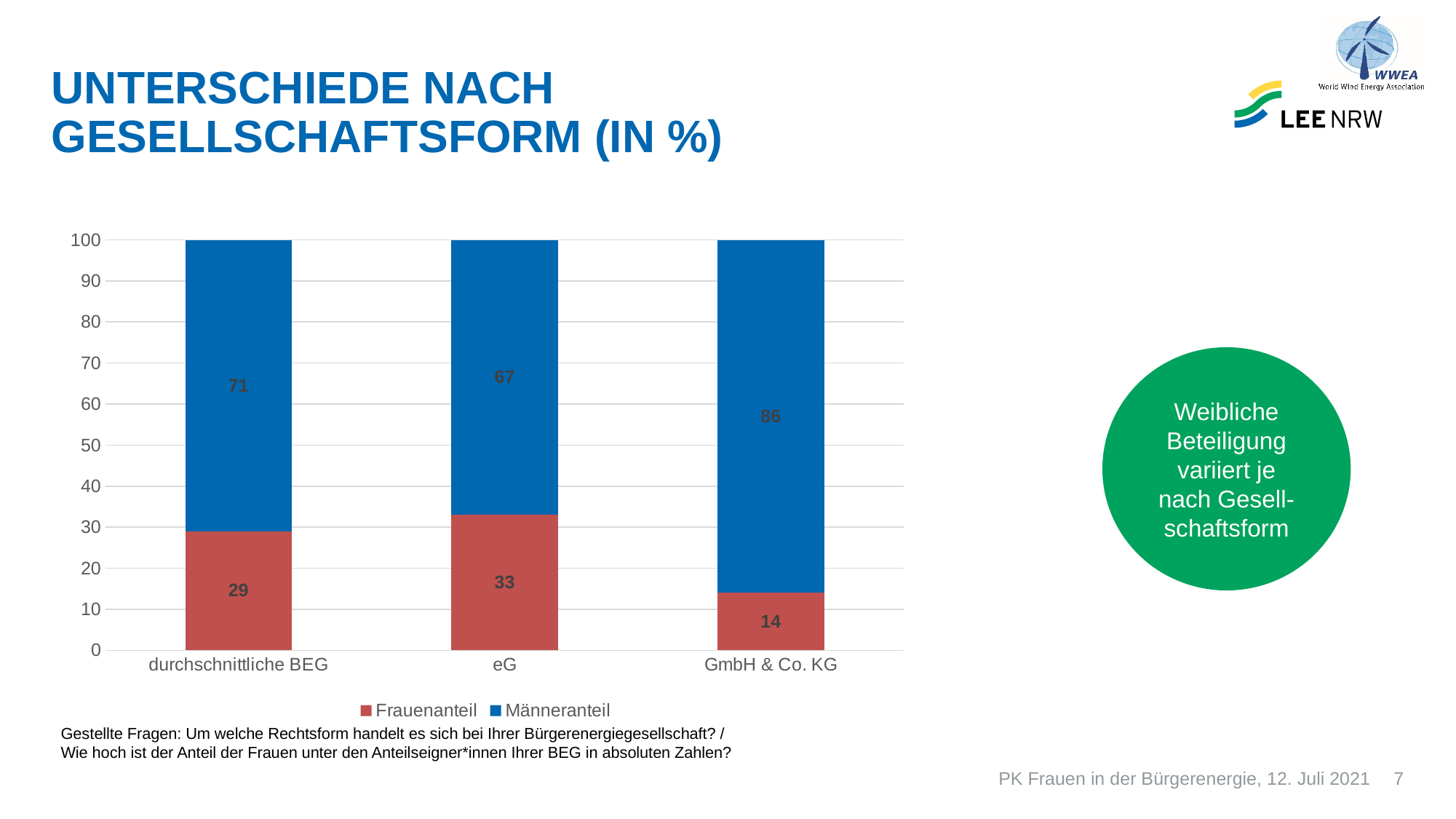
Which colour represents Frauenanteil in the chart? Red Which category has the highest Frauenanteil? eG What is the Frauenanteil value for durchschnittliche BEG? 29 Which category has the lowest Frauenanteil? GmbH & Co. KG How many series does the legend list? 2 What is the total of the stacked bar for eG? 100 What kind of chart is shown on the slide? Stacked bar chart Is the Frauenanteil larger for durchschnittliche BEG or for GmbH & Co. KG? durchschnittliche BEG What is the Männeranteil value for GmbH & Co. KG? 86 What is the difference between the Männeranteil for GmbH & Co. KG and for eG? 19 How many categories are shown on the x axis? 3 What is the Frauenanteil value for eG? 33